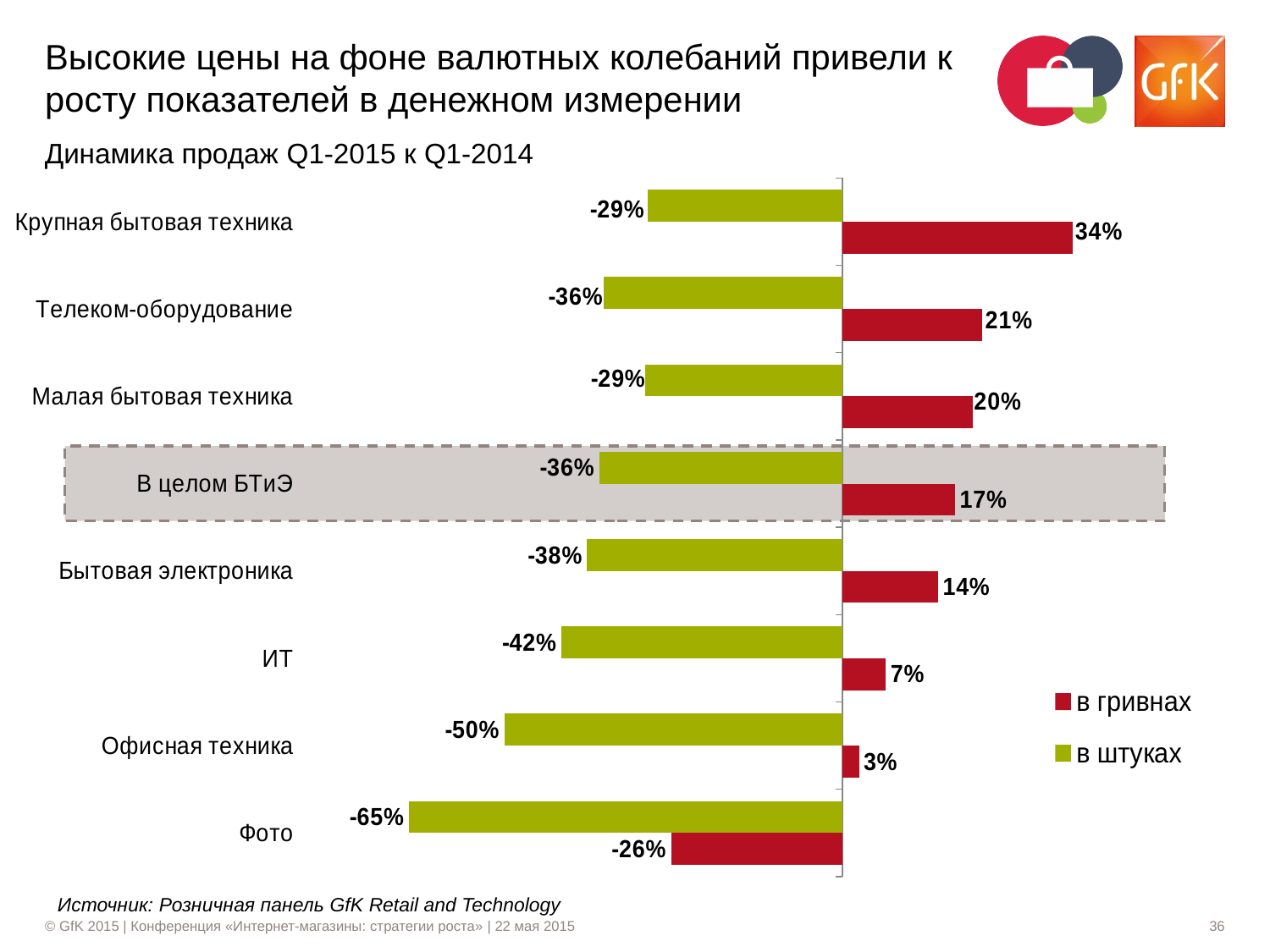
What is the value for Бытовая электроника in the в штуках series? -38% How many series does the legend list? 2 Which category has the lowest value in the в штуках series? Фото Which category has the highest value in the в гривнах series? Крупная бытовая техника What is the value for Крупная бытовая техника in the в гривнах series? 34% Which colour represents the в штуках series? Green What is the difference between the в гривнах values for Крупная бытовая техника and Телеком-оборудование? 13% What kind of chart is shown on the slide? Bar chart What is the value for Фото in the в штуках series? -65% Which is larger: the в гривнах value for Малая бытовая техника or for Бытовая электроника? Малая бытовая техника What is the value for ИТ in the в гривнах series? 7% How many categories are shown on the chart? 8